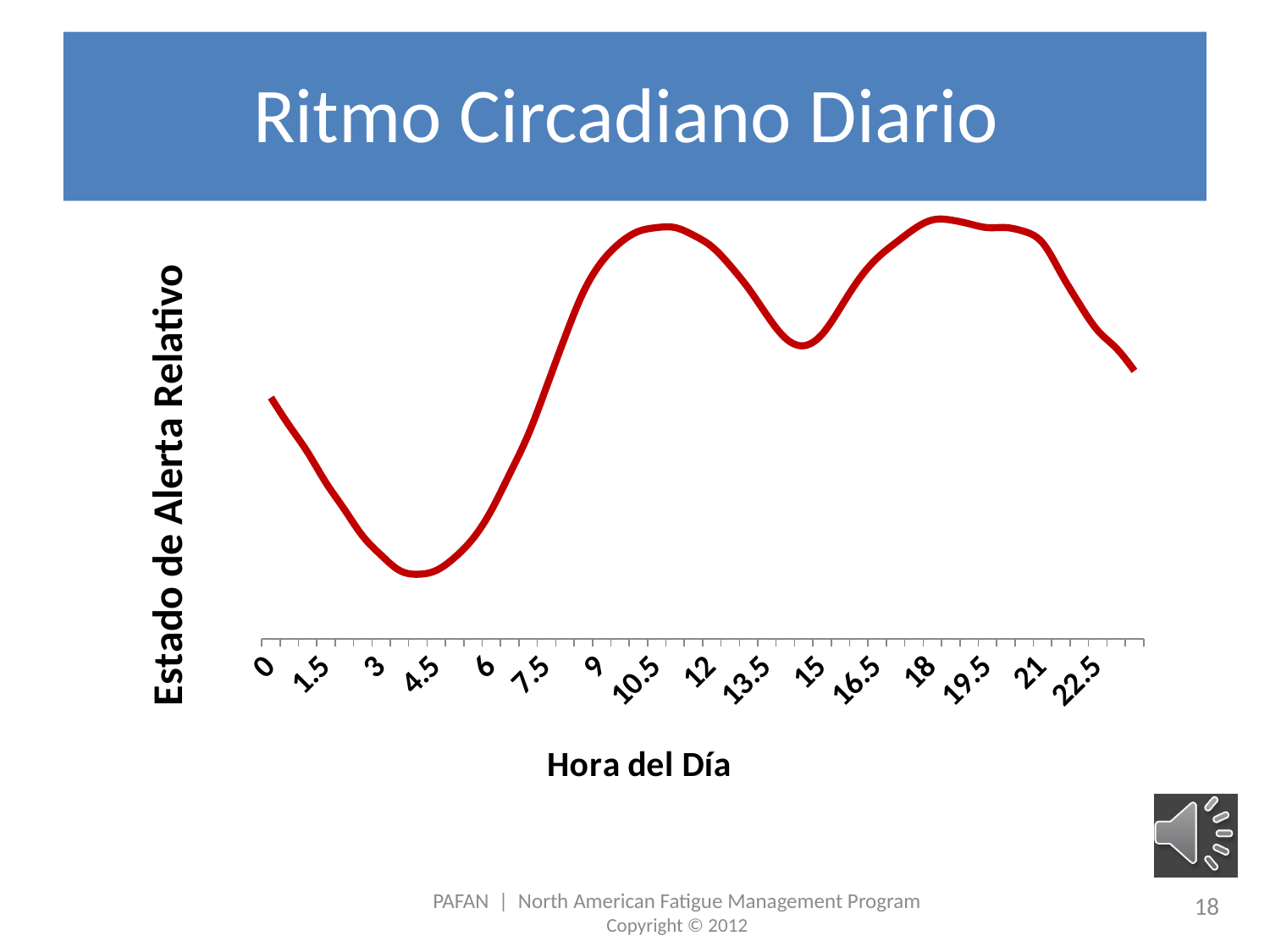
Which has the higher alertness value on the line, hour 3 or hour 9? 9 Which has the higher alertness value on the line, hour 0 or hour 18? 18 Does the line rise or fall between hour 21 and hour 22.5? fall What is the label of the horizontal axis of the chart? Hora del Día Does the line rise or fall between hour 4.5 and hour 10.5? rise How many hour labels are shown along the x axis of the chart? 16 Does the line rise or fall between hour 10.5 and hour 15? fall What kind of chart is shown on the slide? line chart Which has the lower alertness value on the line, hour 4.5 or hour 15? 4.5 What is the title of the chart on the slide? Ritmo Circadiano Diario